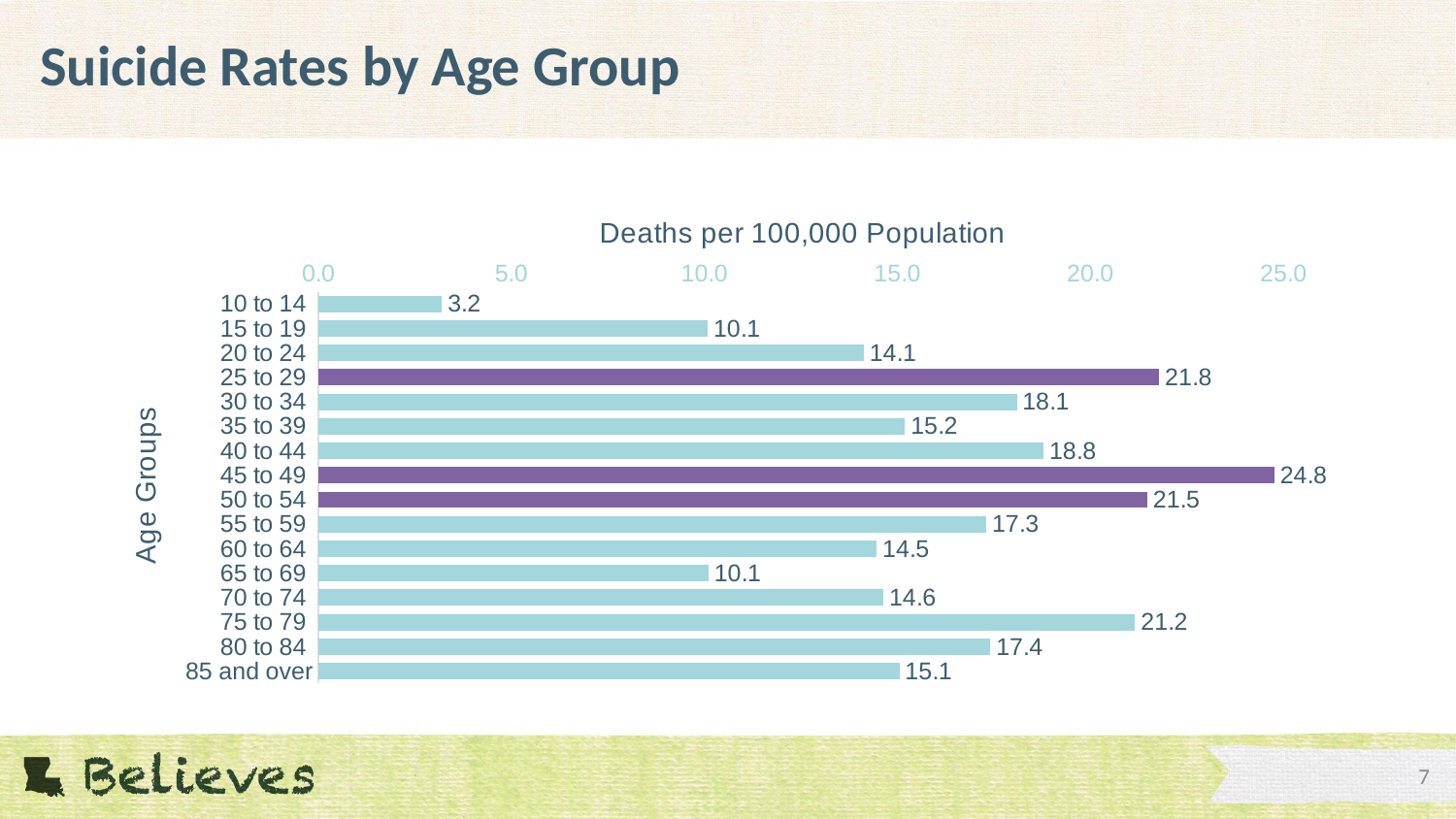
What is the title of the chart's horizontal axis? Deaths per 100,000 Population Which has a higher value, 30 to 34 or 40 to 44? 40 to 44 What is the value shown for the 10 to 14 age group? 3.2 What is the value for the 85 and over age group? 15.1 Is the value for 75 to 79 greater or less than 20.0? greater What is the suicide rate for the 45 to 49 age group? 24.8 What is the difference between the values for 25 to 29 and 50 to 54? 0.3 What is the difference between the values for 45 to 49 and 10 to 14? 21.6 How many age groups are shown in the chart? 16 Which age group has the lowest suicide rate? 10 to 14 Which age group has the highest suicide rate? 45 to 49 What kind of chart is shown on the slide? Bar chart